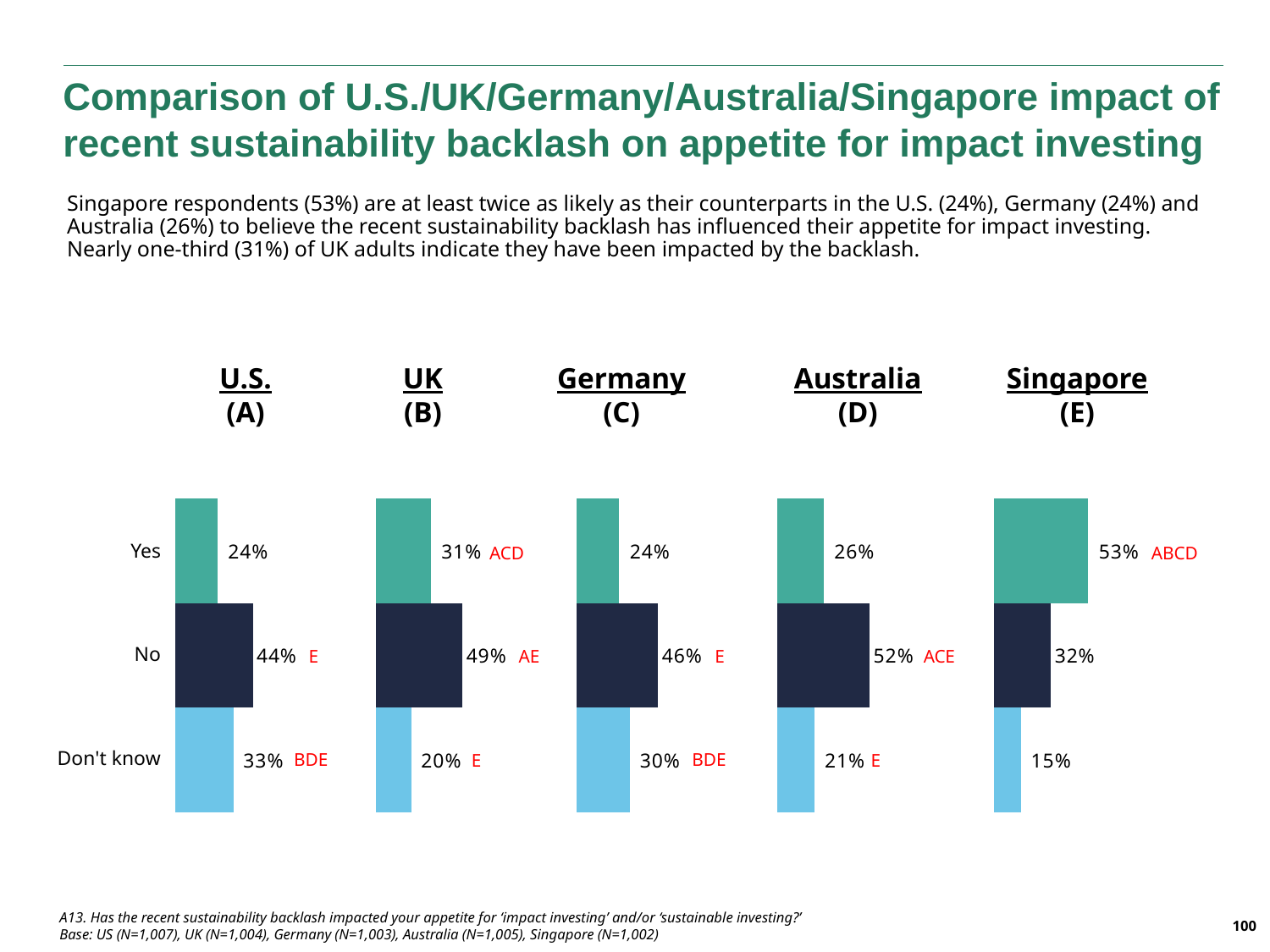
Which country has the lowest 'Don't know' percentage? Singapore How many countries are compared in the chart? 5 What is the difference between the 'No' and 'Yes' percentages for Australia? 26 percentage points What percentage of UK respondents answered 'No'? 49% Which country has the highest 'No' percentage? Australia What is the difference between the 'Yes' percentages for Singapore and the U.S.? 29 percentage points What percentage of Germany respondents answered 'Don't know'? 30% Which is larger, the 'Don't know' percentage for the U.S. or for the UK? U.S. What kind of chart is shown on the slide? Bar chart What percentage of Singapore respondents answered 'Yes'? 53% How many response categories are shown for each country? 3 Which country has the highest 'Yes' percentage? Singapore